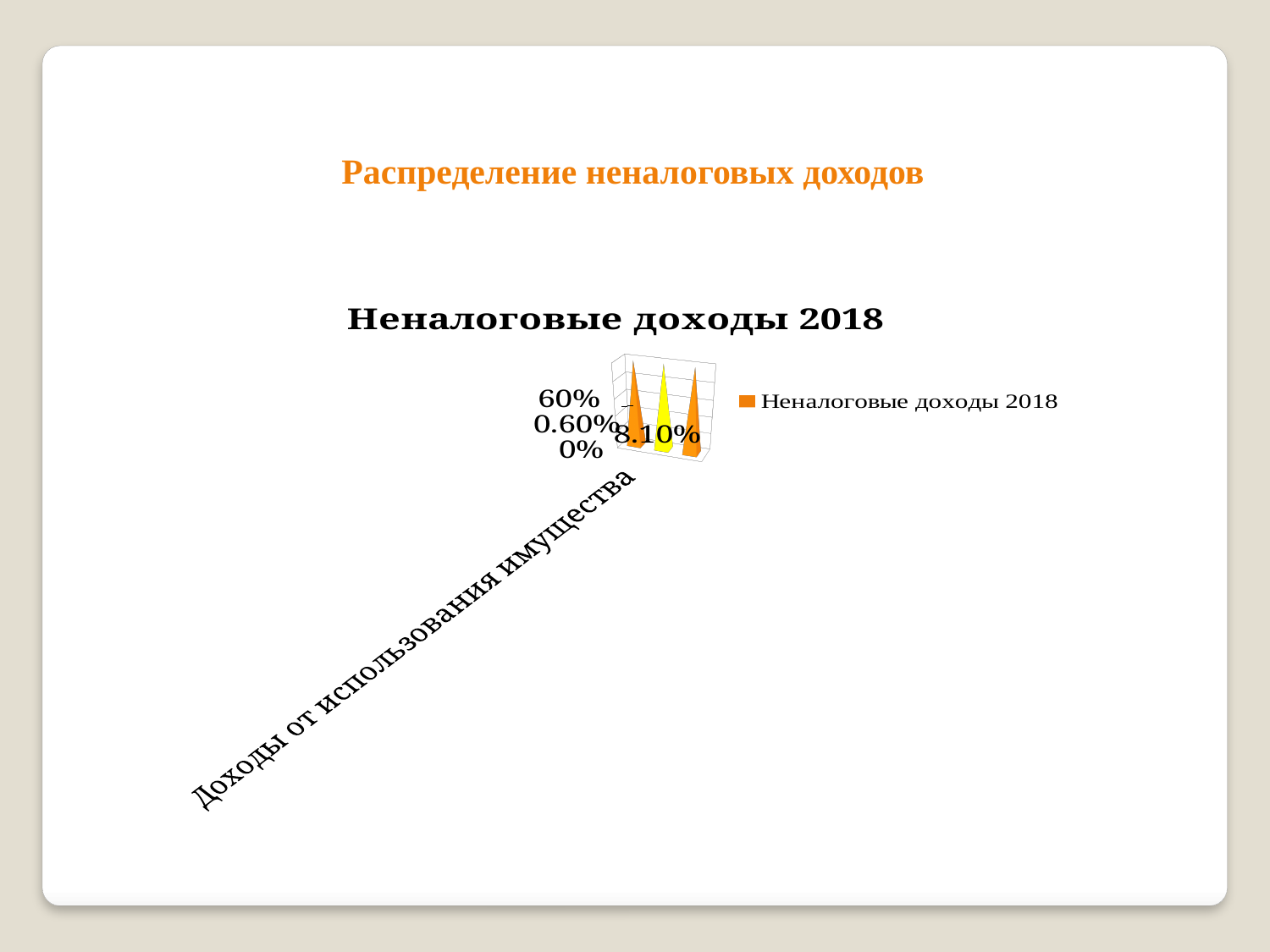
What kind of chart is shown on the slide? bar chart How many bars (cones) are plotted in the chart? 3 What is the highest value shown on the chart's vertical axis? 60% Is the value of the middle (yellow) cone greater or less than 60%? less How many series does the chart legend list? 1 What is the name of the series shown in the chart legend? Неналоговые доходы 2018 What is the title of the chart on the slide? Неналоговые доходы 2018